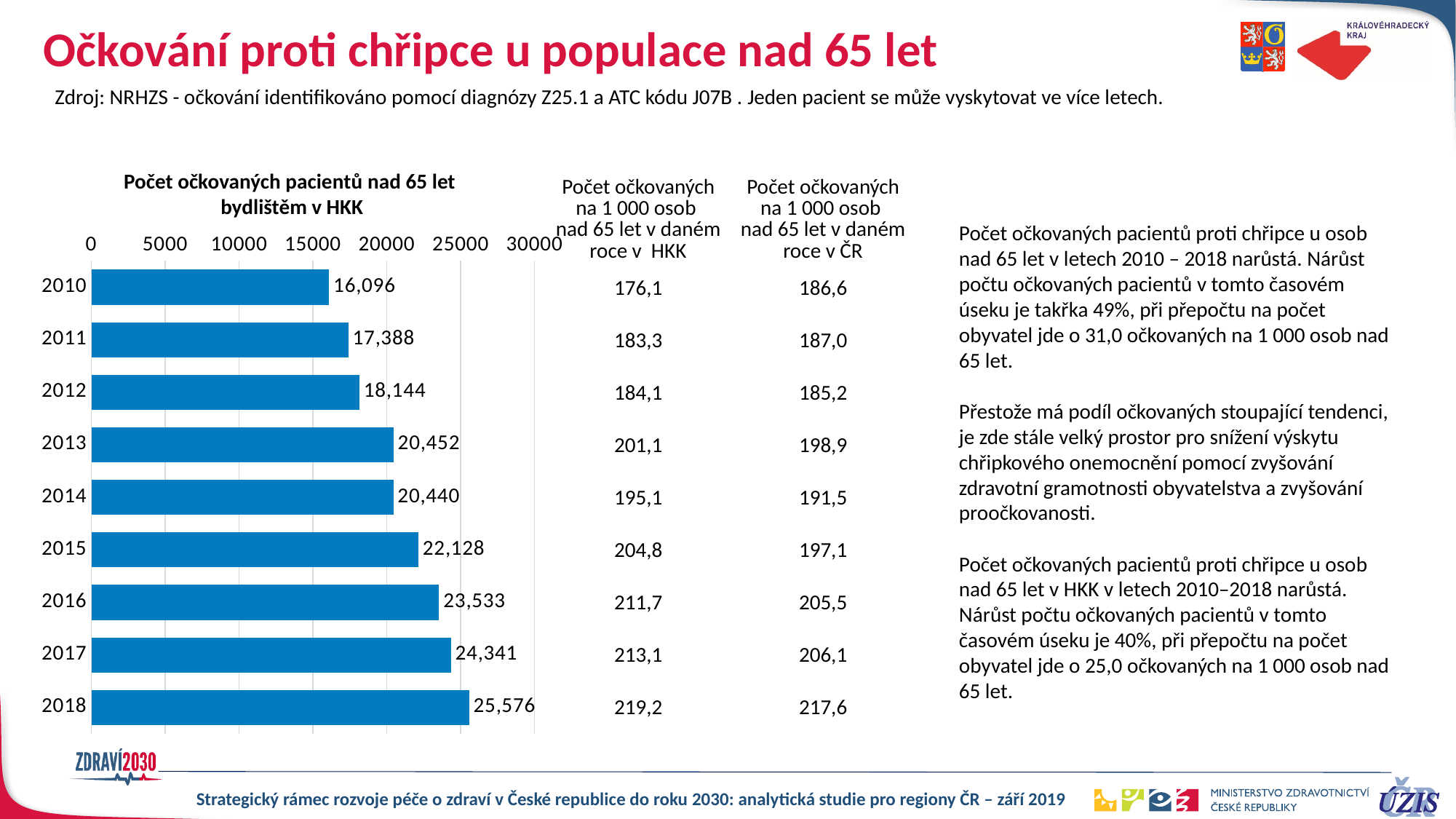
Which year has the lowest value in the bar chart? 2010 Which is larger in the bar chart, the value for 2012 or the value for 2016? 2016 Is the value for 2015 in the bar chart greater or less than 20000? greater What is the value for 2015 in the bar chart? 22,128 Do the values in the bar chart generally rise or fall from 2010 to 2018? rise What is the value for 2010 in the bar chart? 16,096 How many years are shown in the bar chart? 9 What is the difference between the values for 2018 and 2010 in the bar chart? 9,480 What is the difference between the values for 2017 and 2016 in the bar chart? 808 What kind of chart is shown on the slide? bar chart Which year has the highest value in the bar chart? 2018 What is the value for 2018 in the bar chart? 25,576